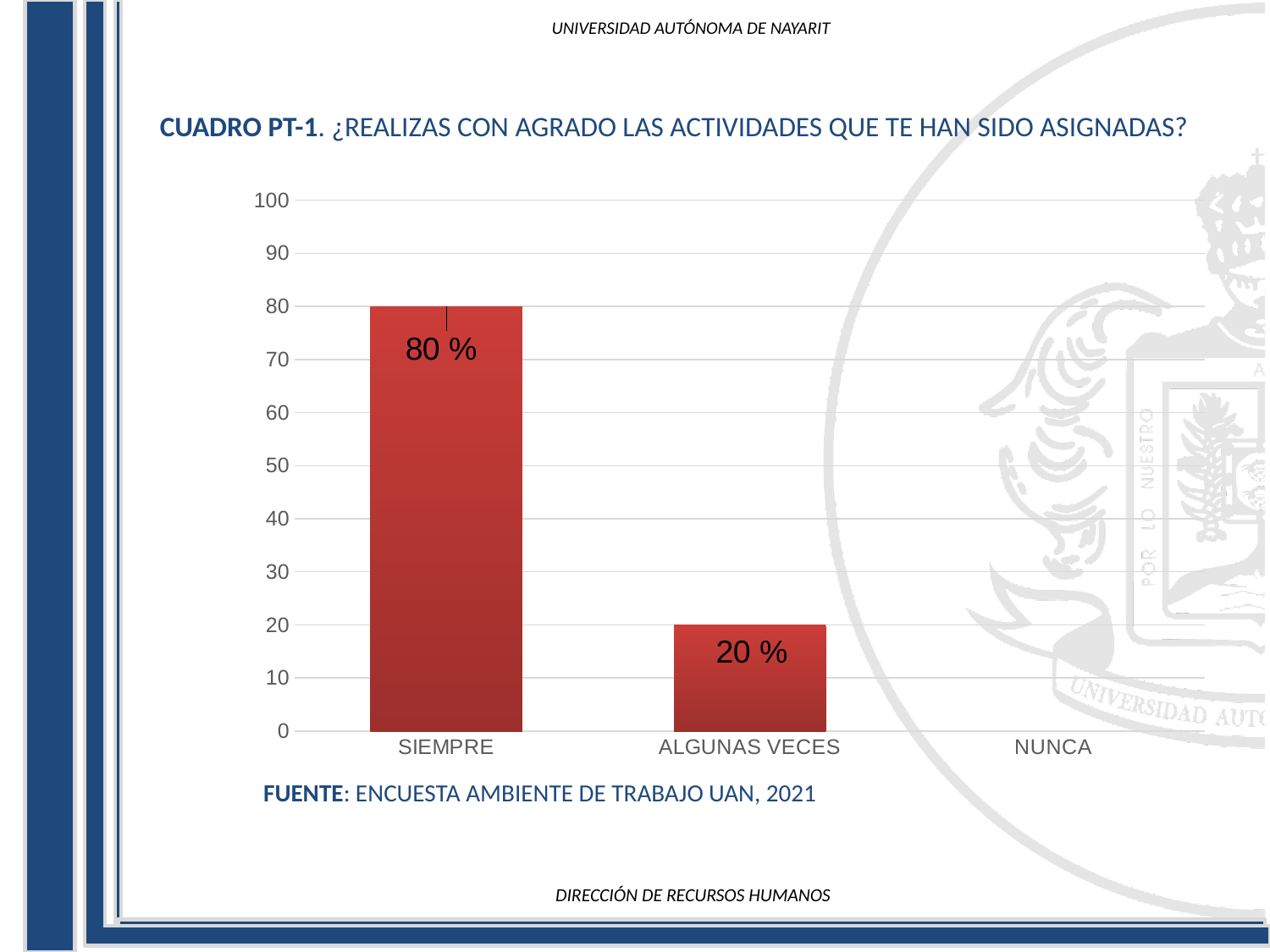
Is the value for ALGUNAS VECES greater or less than 30? less What is the source cited below the chart? ENCUESTA AMBIENTE DE TRABAJO UAN, 2021 Which category has the highest value? SIEMPRE What is the value for ALGUNAS VECES? 20 % How many categories are shown on the x axis? 3 What is the maximum value shown on the y axis? 100 Which is larger, the value for SIEMPRE or the value for ALGUNAS VECES? SIEMPRE Is the value for SIEMPRE greater or less than 50? greater Do the values rise or fall from SIEMPRE to ALGUNAS VECES? Fall What kind of chart is shown on the slide? Bar chart What is the value for SIEMPRE? 80 % What is the difference between the values for SIEMPRE and ALGUNAS VECES? 60 %